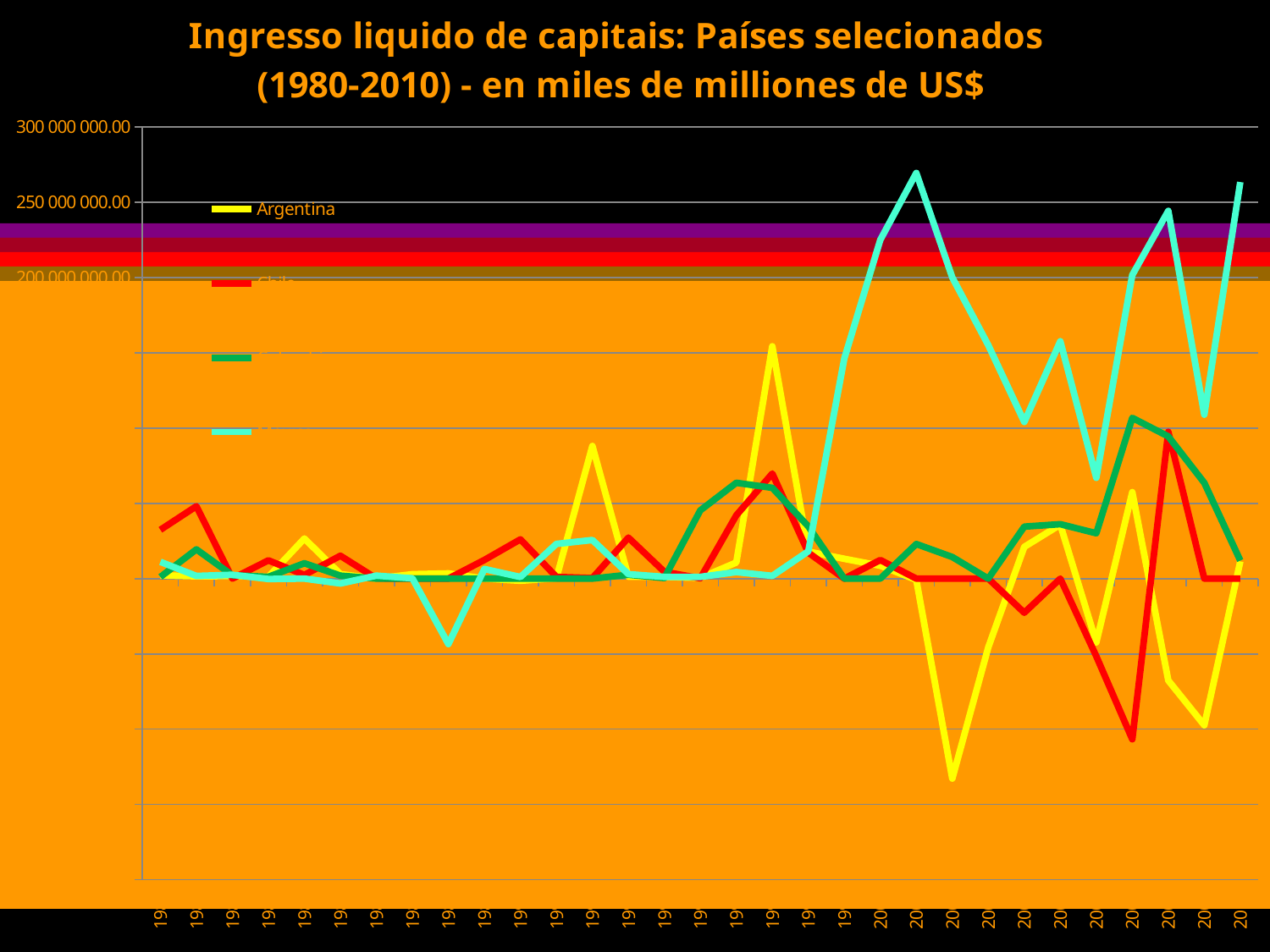
What is the highest value labelled on the vertical axis? 300 000 000.00 Is the highest peak of the cyan line greater or less than 250 000 000.00? greater Is the highest peak of the Argentina line greater or less than 200 000 000.00? less How many data points (years) are plotted along the x axis? 31 How many series does the legend list? 4 What kind of chart is shown on the slide? line chart Which line reaches the highest peak on the chart? the cyan line Which colour is used for the Argentina series? yellow What is the title of the chart? Ingresso liquido de capitais: Países selecionados (1980-2010) - en miles de milliones de US$ At the last year plotted, which is higher: the cyan line or the Argentina line? the cyan line Which period does the chart cover according to its title? 1980-2010 Does the cyan line end higher or lower than it starts? higher